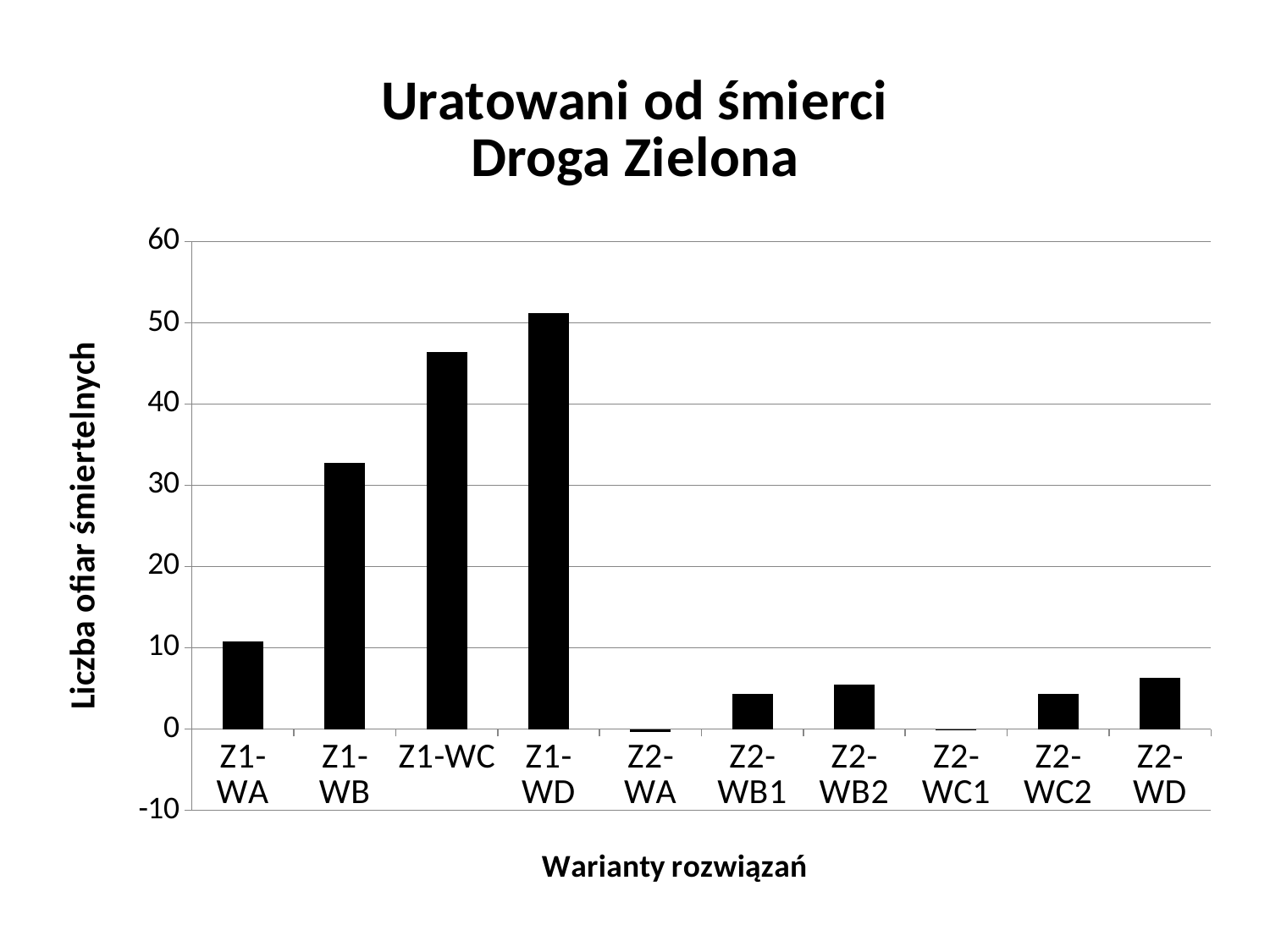
What kind of chart is shown on the slide? bar chart What is the title of the chart? Uratowani od śmierci Droga Zielona Is the value for Z1-WC greater or less than 40? greater What is the label of the y axis? Liczba ofiar śmiertelnych Is the value for Z1-WA greater or less than 20? less Which variant has the highest number of saved lives? Z1-WD Is the value for Z2-WB2 greater or less than 10? less Which is larger, the value for Z1-WA or the value for Z2-WD? Z1-WA Which is larger, the value for Z1-WC or the value for Z1-WB? Z1-WC How many categories (variants) are shown on the x axis? 10